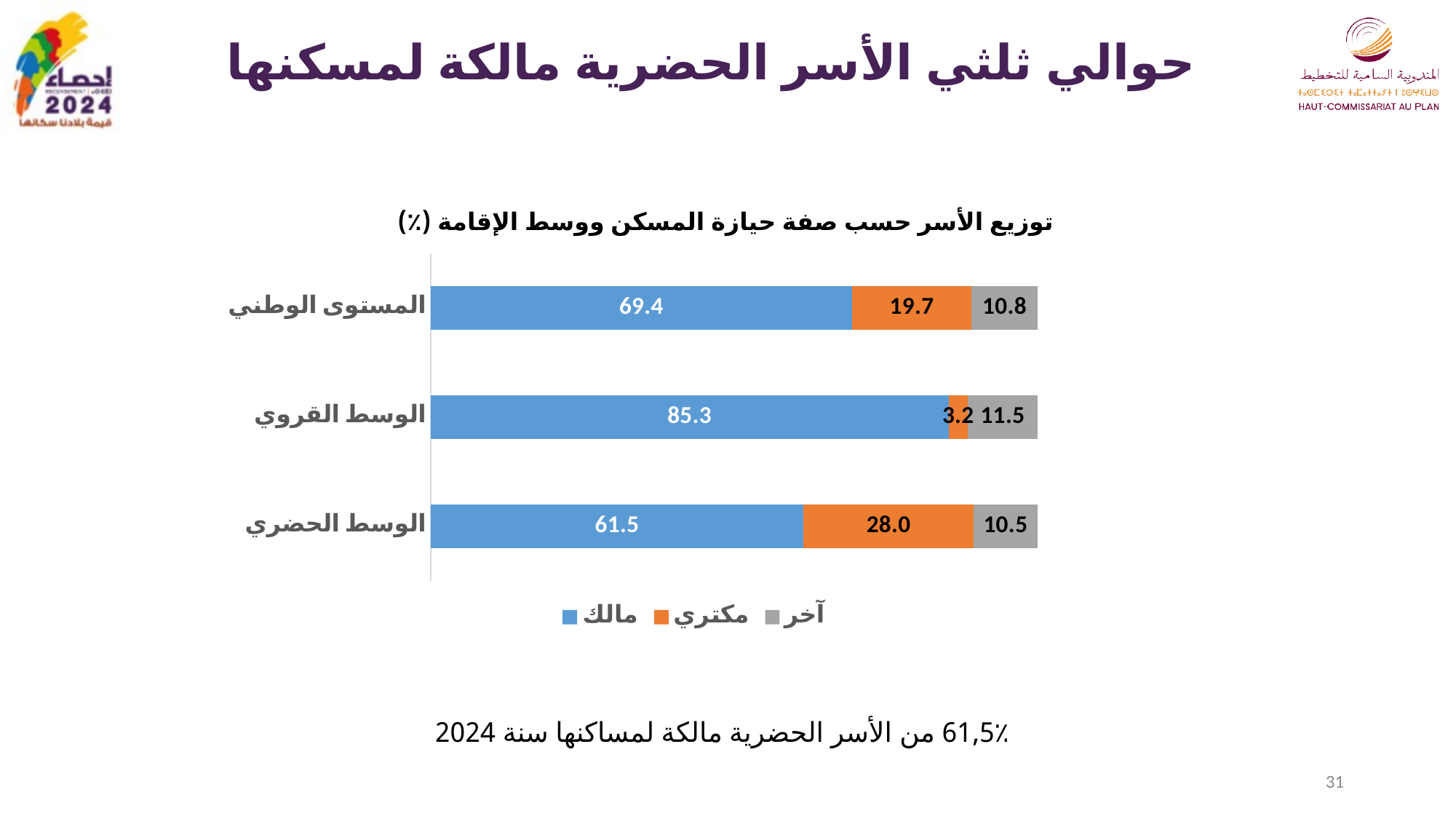
Which category has the lowest value for مكتري? الوسط القروي What is the value for مكتري in the الوسط القروي bar? 3.2 What is the value for مالك in the الوسط الحضري bar? 61.5 How many categories are shown on the chart? 3 How many series does the legend list? 3 Which colour represents the مكتري series in the legend? Orange What is the value for آخر in the المستوى الوطني bar? 10.8 Which is larger: the مكتري value for الوسط الحضري or for المستوى الوطني? الوسط الحضري Which category has the highest value for مالك? الوسط القروي What is the total of the stacked bar for الوسط الحضري? 100.0 What kind of chart is shown on the slide? Stacked bar chart What is the difference between the مالك values for الوسط القروي and الوسط الحضري? 23.8